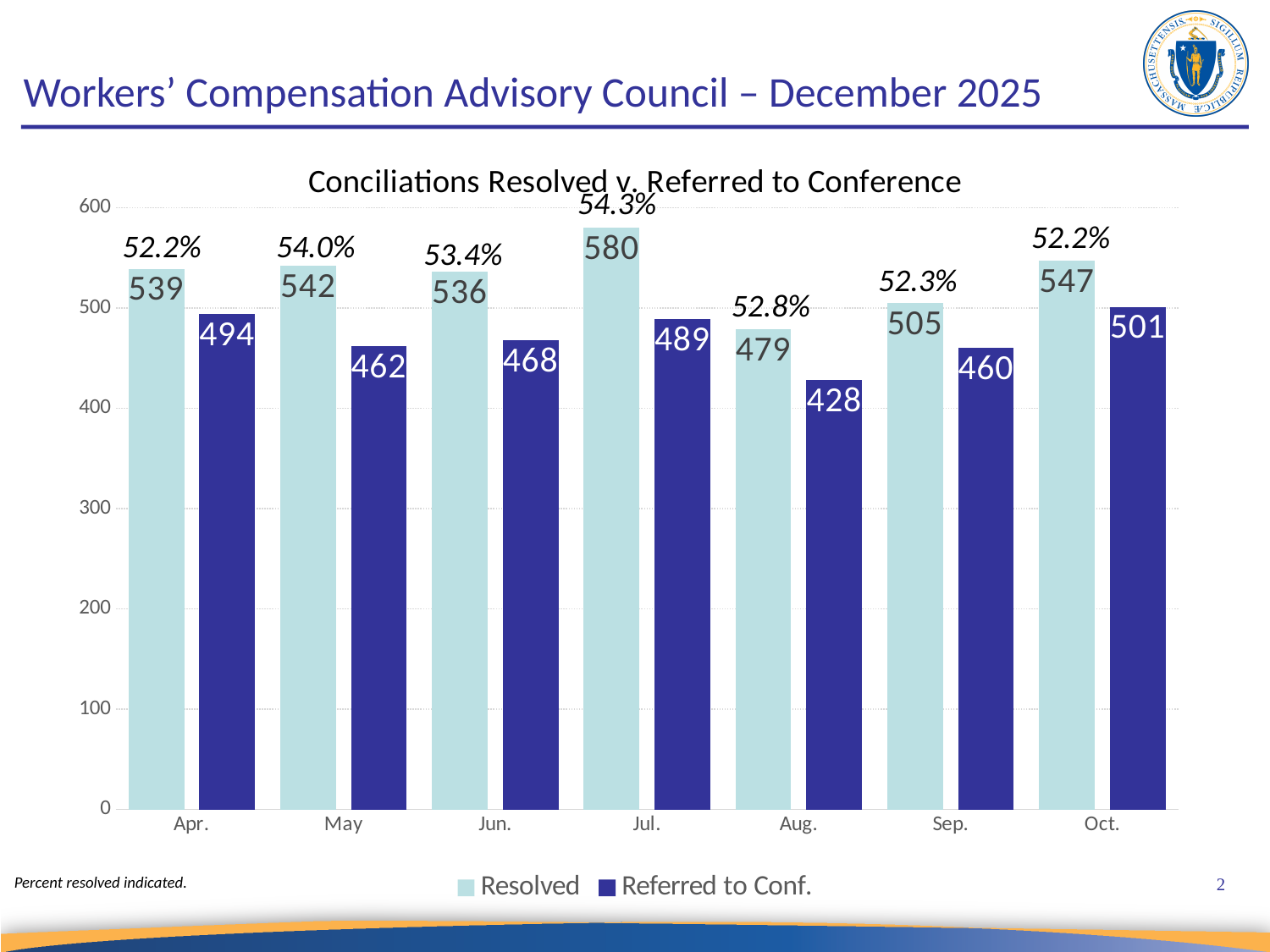
What percent resolved is indicated for May? 54.0% What is the title of the chart? Conciliations Resolved v. Referred to Conference Which month has the lowest Referred to Conf. value? Aug. Which is larger, the Referred to Conf. value for April or for May? April What is the Referred to Conf. value for August? 428 Is the Resolved value for August greater or less than 500? less Which month has the highest Resolved value? Jul. What is the Resolved value for July? 580 What kind of chart is shown on the slide? bar chart How many months are shown on the x axis? 7 What is the difference between the Resolved and Referred to Conf. values in July? 91 How many series does the legend list? 2